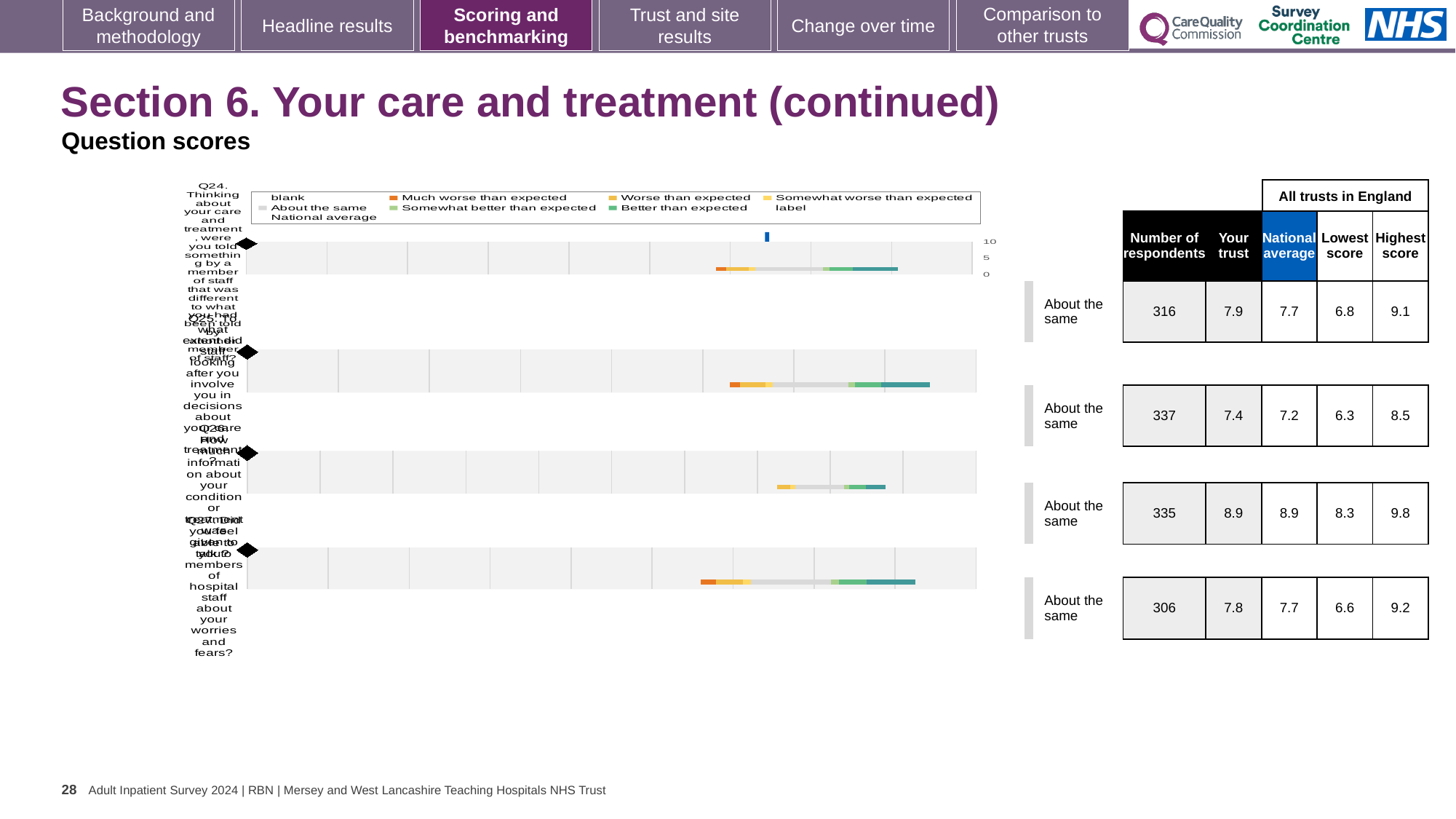
What kind of chart is shown on the slide? bar chart Which legend entry is shown in grey in the chart's legend? About the same In the table beside the chart, which row has the highest 'Your trust' score? Q26 (8.9) In the table beside the chart, what is the number of respondents for the third row (Q26)? 335 How many question rows (bars) does the chart show? 4 In the table beside the chart, is the 'Your trust' score for the second row (Q25) larger or smaller than its national average? larger In the table beside the chart, what is the highest score for the fourth row (Q27)? 9.2 Which legend entry is shown in orange in the chart's legend? Much worse than expected How many entries does the chart's legend list? 9 In the table beside the chart, what is the national average for the second row (Q25)? 7.2 In the table beside the chart, what is the difference between the highest score and the lowest score for the first row (Q24)? 2.3 In the table beside the chart, what is the 'Your trust' score for the first row (Q24)? 7.9